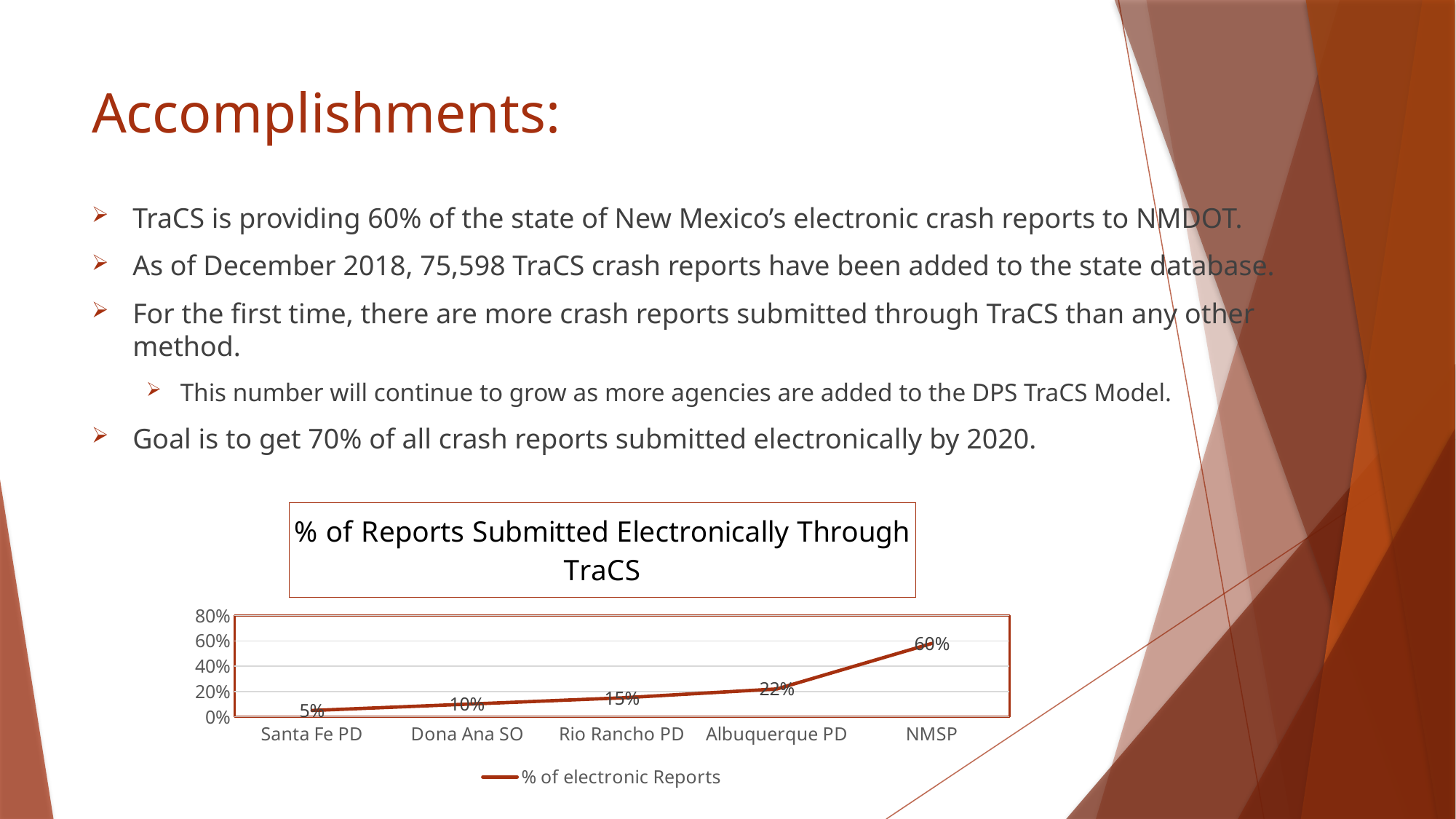
Which agency has the lowest percentage of reports submitted electronically through TraCS? Santa Fe PD How many agencies are plotted on the chart? 5 What is the value for Albuquerque PD? 22% What is the value for NMSP? 60% Do the values rise or fall from Santa Fe PD to NMSP along the x axis? Rise What kind of chart is shown on the slide? Line chart What is the value for Dona Ana SO? 10% Which agency has the highest percentage of reports submitted electronically through TraCS? NMSP Which is larger, the value for Rio Rancho PD or the value for Dona Ana SO? Rio Rancho PD What is the value for Rio Rancho PD? 15% What is the value for Santa Fe PD? 5% What is the difference between the values for NMSP and Albuquerque PD? 38%